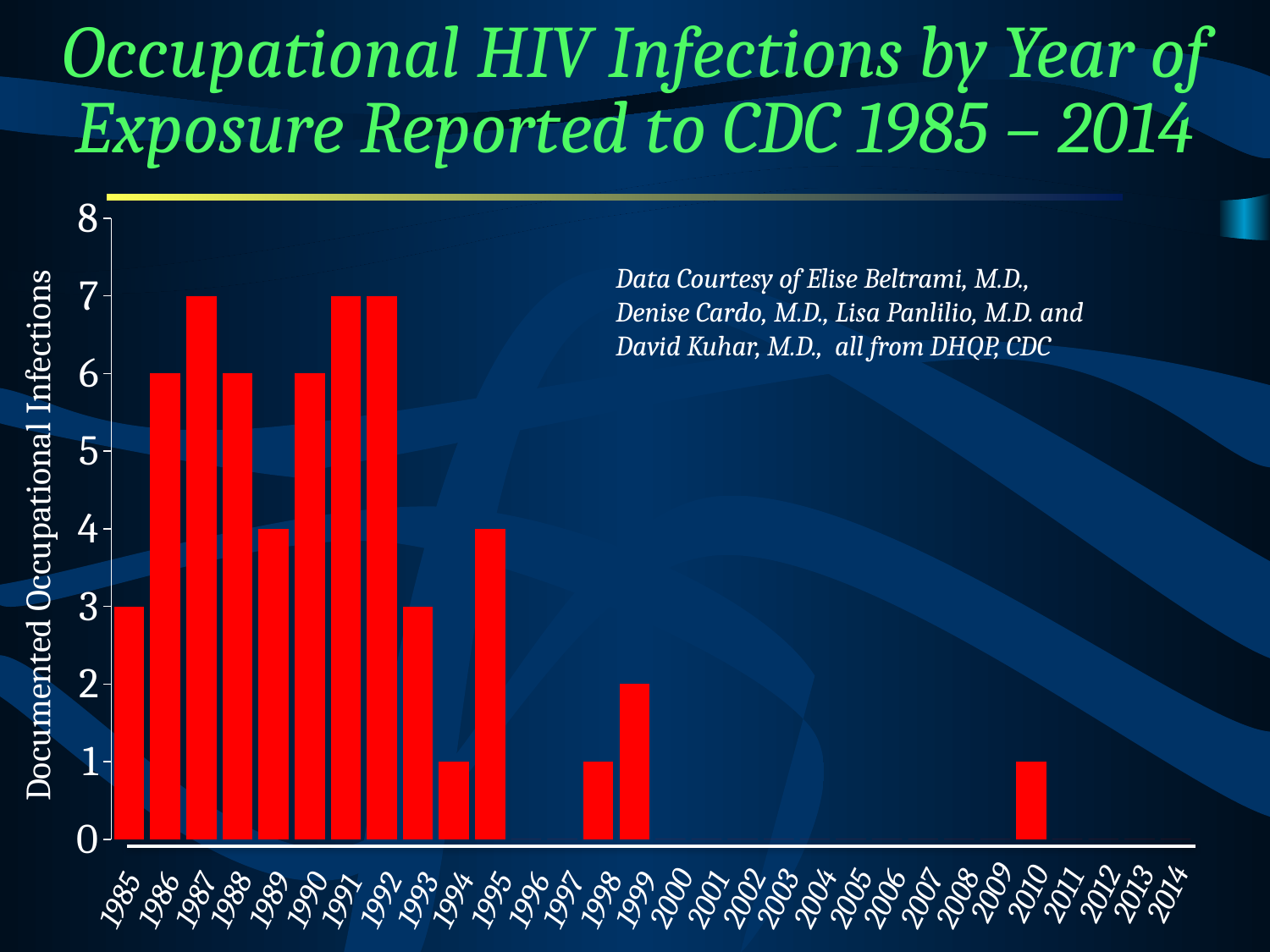
Do the values generally rise or fall from 1985 to 2014? fall What is the difference between the values for 1987 and 1985? 4 What is the value for 1987? 7 What kind of chart is shown on the slide? bar chart How many documented occupational infections are shown for 1985? 3 Is the value for 1991 greater or less than 5? greater Which year has the larger value, 1986 or 1989? 1986 What is the value for 1989? 4 What is the highest number of documented occupational infections reached in any year? 7 What is the value for 1999? 2 What is the value for 2010? 1 How many years are shown on the x axis? 30